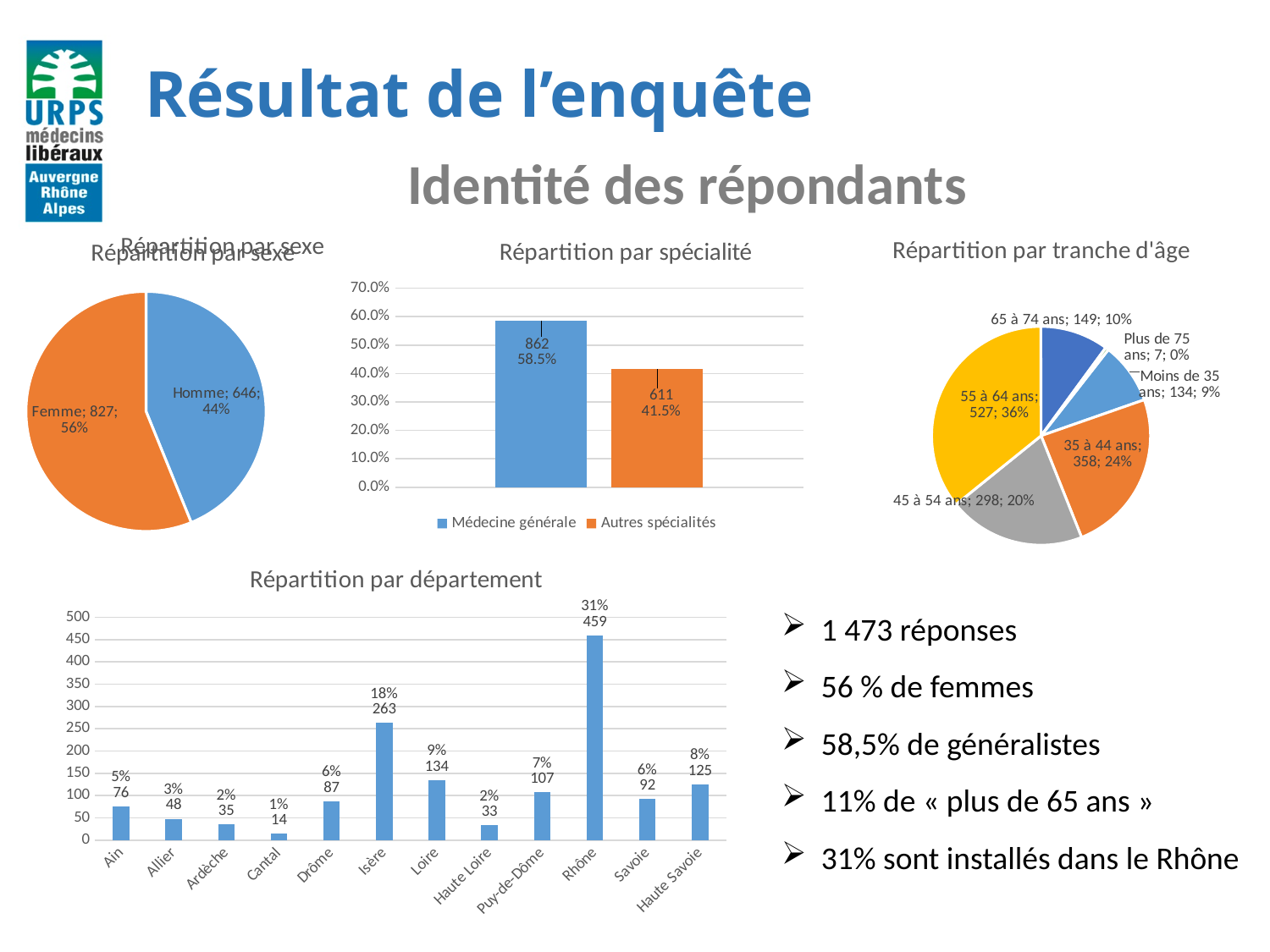
In the 'Répartition par département' chart, which department has the highest value? Rhône In the 'Répartition par sexe' pie chart, what share of the pie is 'Homme'? 44% How many departments are shown in the 'Répartition par département' chart? 12 In the 'Répartition par spécialité' chart, what is the value for 'Médecine générale'? 862 In the 'Répartition par département' chart, which department has the lowest value? Cantal In the 'Répartition par tranche d'âge' pie chart, which age group has the largest slice? 55 à 64 ans In the 'Répartition par tranche d'âge' pie chart, how many respondents are in the '35 à 44 ans' group? 358 What kind of chart is 'Répartition par spécialité'? Bar chart How many slices does the 'Répartition par tranche d'âge' pie chart have? 6 In the 'Répartition par département' chart, what is the value for 'Isère'? 263 In the 'Répartition par spécialité' chart, what is the difference between the counts for 'Médecine générale' and 'Autres spécialités'? 251 In the 'Répartition par sexe' pie chart, how many respondents are 'Femme'? 827